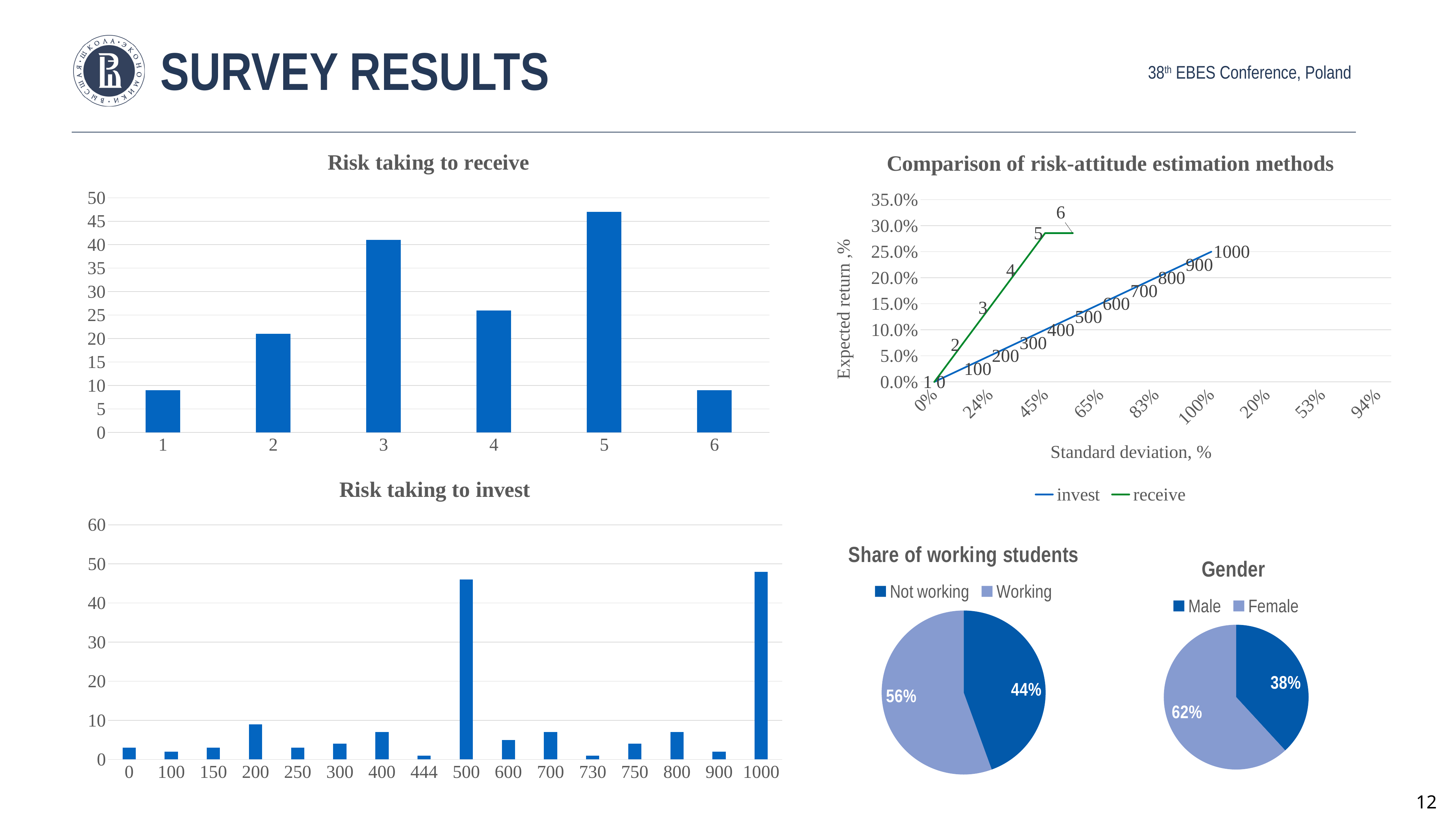
How many series does the legend of the 'Comparison of risk-attitude estimation methods' chart list? 2 In the 'Risk taking to receive' chart, is the value for category 5 greater or less than 40? greater What kind of chart is 'Comparison of risk-attitude estimation methods'? line chart In the 'Risk taking to invest' chart, is the value for category 500 greater or less than 40? greater In the 'Risk taking to invest' chart, is the value for category 0 greater or less than 10? less In the 'Gender' pie chart, what is the value for 'Male'? 38% In the 'Share of working students' pie chart, what share is labelled for 'Working'? 56% How many categories are shown on the x axis of the 'Risk taking to receive' chart? 6 How many categories are shown on the x axis of the 'Risk taking to invest' chart? 16 In the 'Risk taking to receive' chart, which category has the highest bar? 5 In the 'Gender' pie chart, what is the difference between the Female and Male shares? 24%